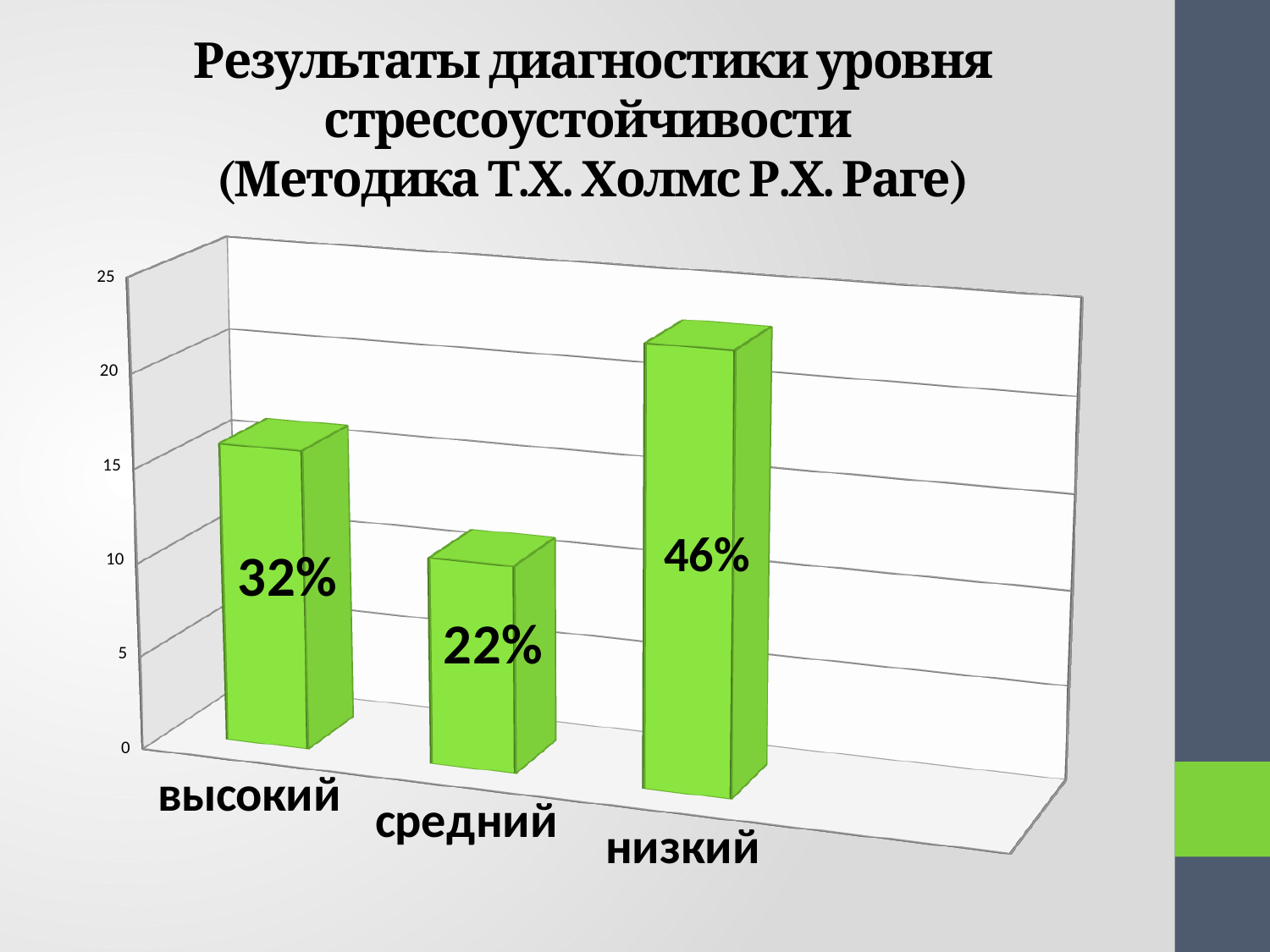
Which category has the highest bar? низкий Which is larger, the value for «высокий» or the value for «средний»? высокий What is the difference between the labelled values for «высокий» and «средний»? 10% How many categories are shown on the chart? 3 Which category has the lowest bar? средний What type of chart is shown on the slide? bar chart Is the bar for «низкий» greater or less than 20 on the vertical axis? greater What is the data label on the bar for «средний»? 22% Is the bar for «средний» greater or less than 15 on the vertical axis? less What is the difference between the labelled values for «низкий» and «средний»? 24% What is the data label on the bar for «высокий»? 32% What is the data label on the bar for «низкий»? 46%